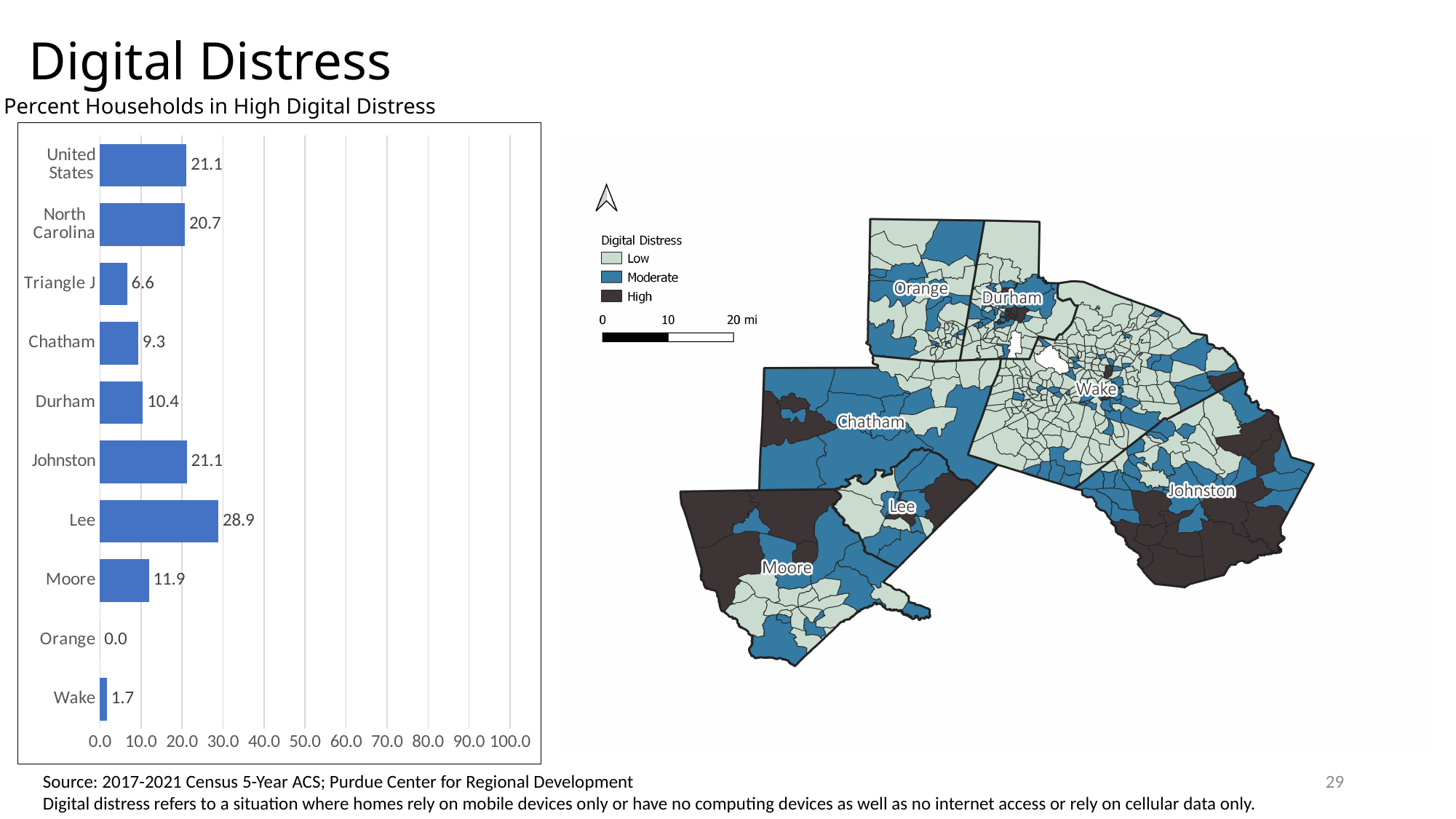
In the bar chart, which category has the highest percent of households in high digital distress? Lee What type of chart is used to show percent households in high digital distress? Bar chart In the bar chart, is the value for Lee greater or less than 20.0? greater In the bar chart, what value is shown for North Carolina? 20.7 In the bar chart, what value is shown for Triangle J? 6.6 In the bar chart, which category has the lowest value? Orange In the bar chart, what value is shown for Wake? 1.7 In the bar chart, what is the difference between the values for Lee and Johnston? 7.8 In the bar chart, which has a larger value, Moore or Durham? Moore In the bar chart, what is the difference between the values for United States and North Carolina? 0.4 In the bar chart, what is the percent of households in high digital distress for Lee? 28.9 How many categories are shown in the bar chart? 10